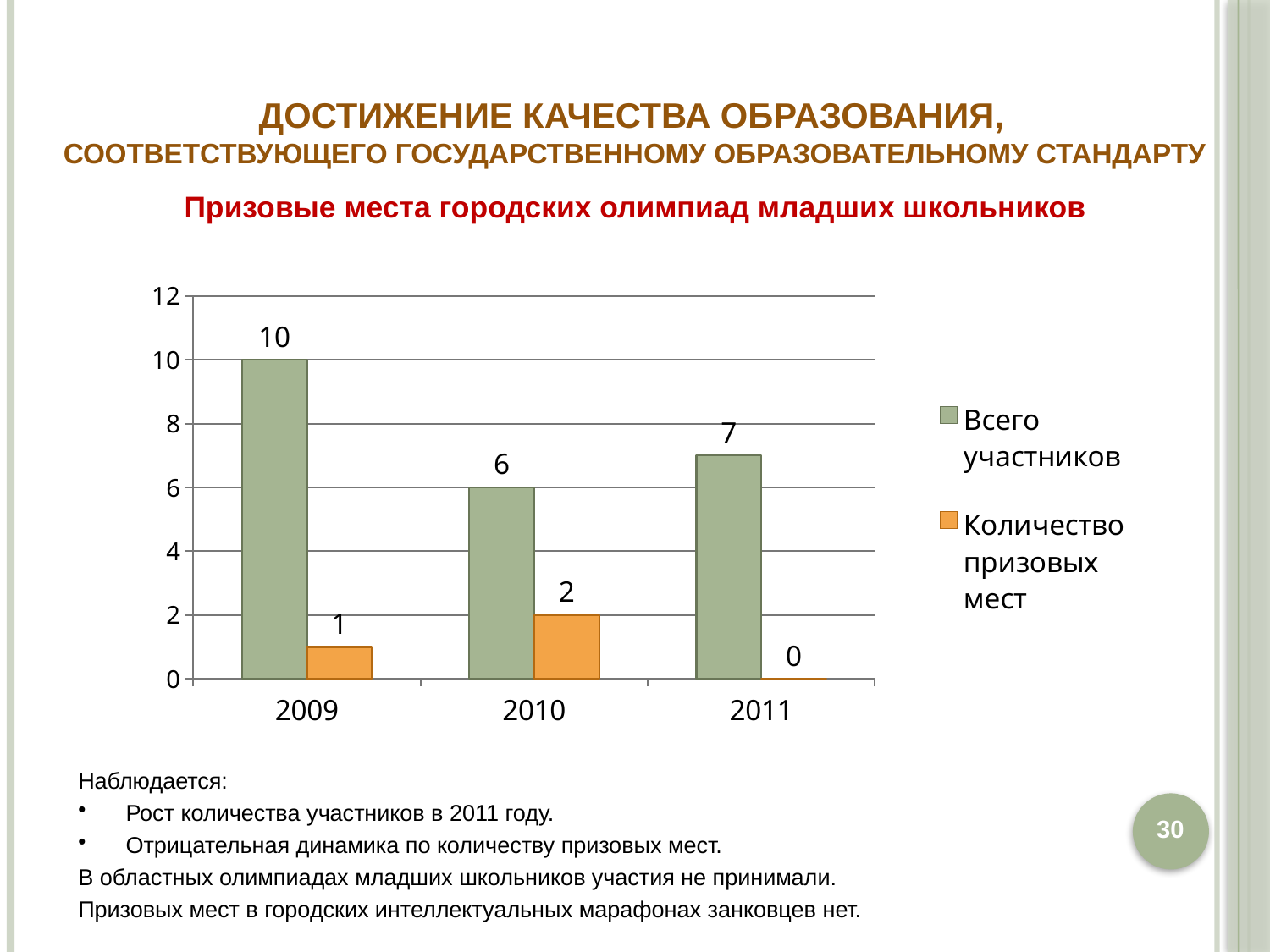
What is the difference between "Всего участников" in 2009 and in 2010? 4 Which year has the highest value for "Всего участников"? 2009 Which year has the lowest value for "Количество призовых мест"? 2011 Does the value for "Количество призовых мест" rise or fall from 2010 to 2011? fall Which is larger: "Всего участников" in 2010 or in 2011? 2011 What is the value for "Количество призовых мест" in 2011? 0 Is the value for "Всего участников" in 2011 greater or less than 8? less How many series does the legend list? 2 What is the value for "Всего участников" in 2009? 10 What kind of chart is shown on the slide? bar chart What is the value for "Количество призовых мест" in 2010? 2 How many years are shown on the x axis? 3